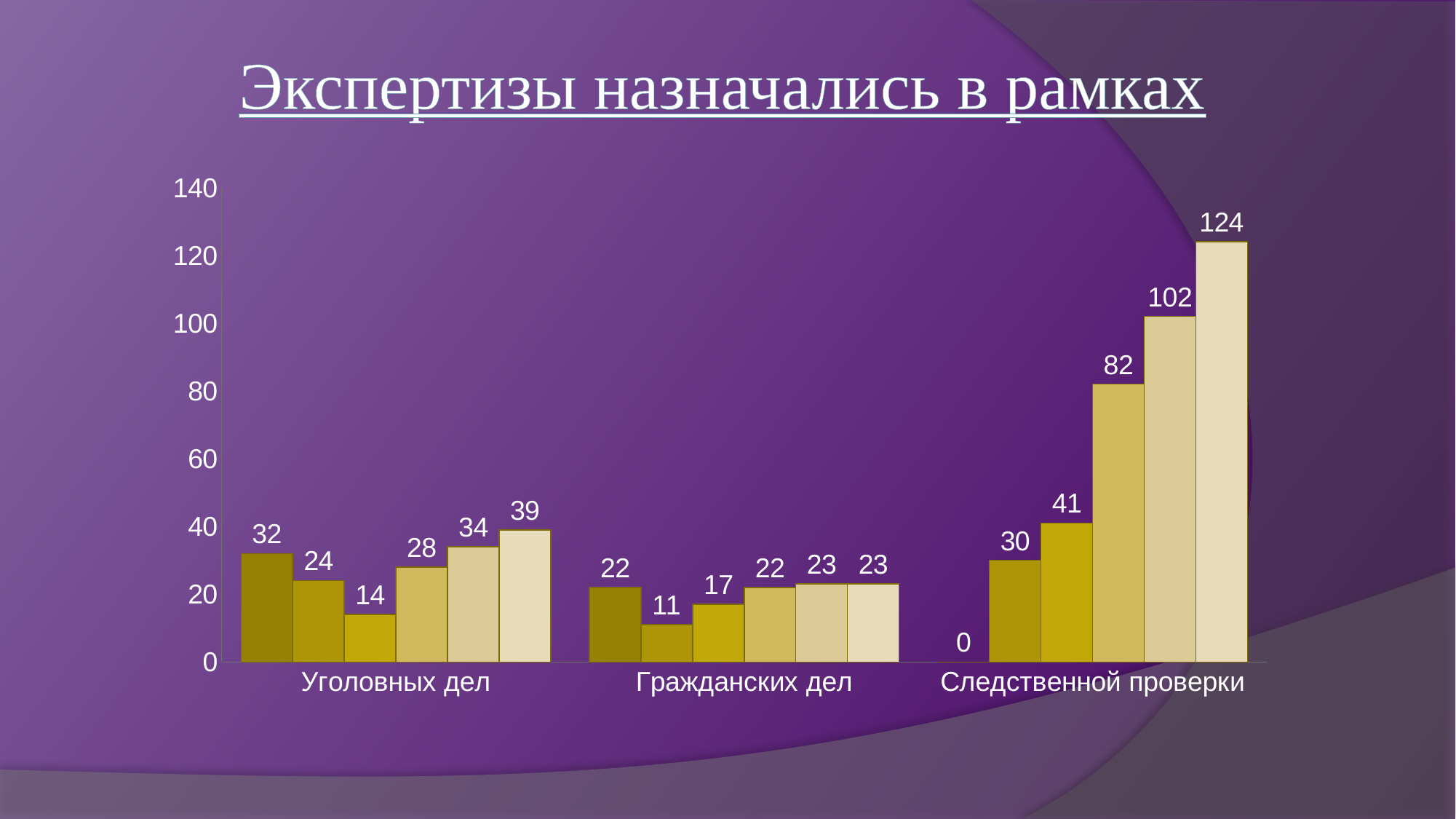
Which category contains the highest bar in the chart? Следственной проверки What is the difference between the rightmost bar in 'Следственной проверки' (124) and the rightmost bar in 'Уголовных дел' (39)? 85 What is the value of the last (rightmost) bar in the 'Уголовных дел' category? 39 How many categories are shown on the x axis of the chart? 3 Do the bar values in the 'Следственной проверки' category rise or fall from left to right? rise What type of chart is shown on the slide? bar chart What is the value of the tallest bar in the 'Следственной проверки' category? 124 Which is larger: the first bar in 'Уголовных дел' or the first bar in 'Гражданских дел'? Уголовных дел What is the value of the lowest bar in the 'Гражданских дел' category? 11 Is the value of the fourth bar in 'Следственной проверки' greater or less than 80? greater What is the title of the chart on the slide? Экспертизы назначались в рамках What is the value of the first (leftmost) bar in the 'Следственной проверки' category? 0